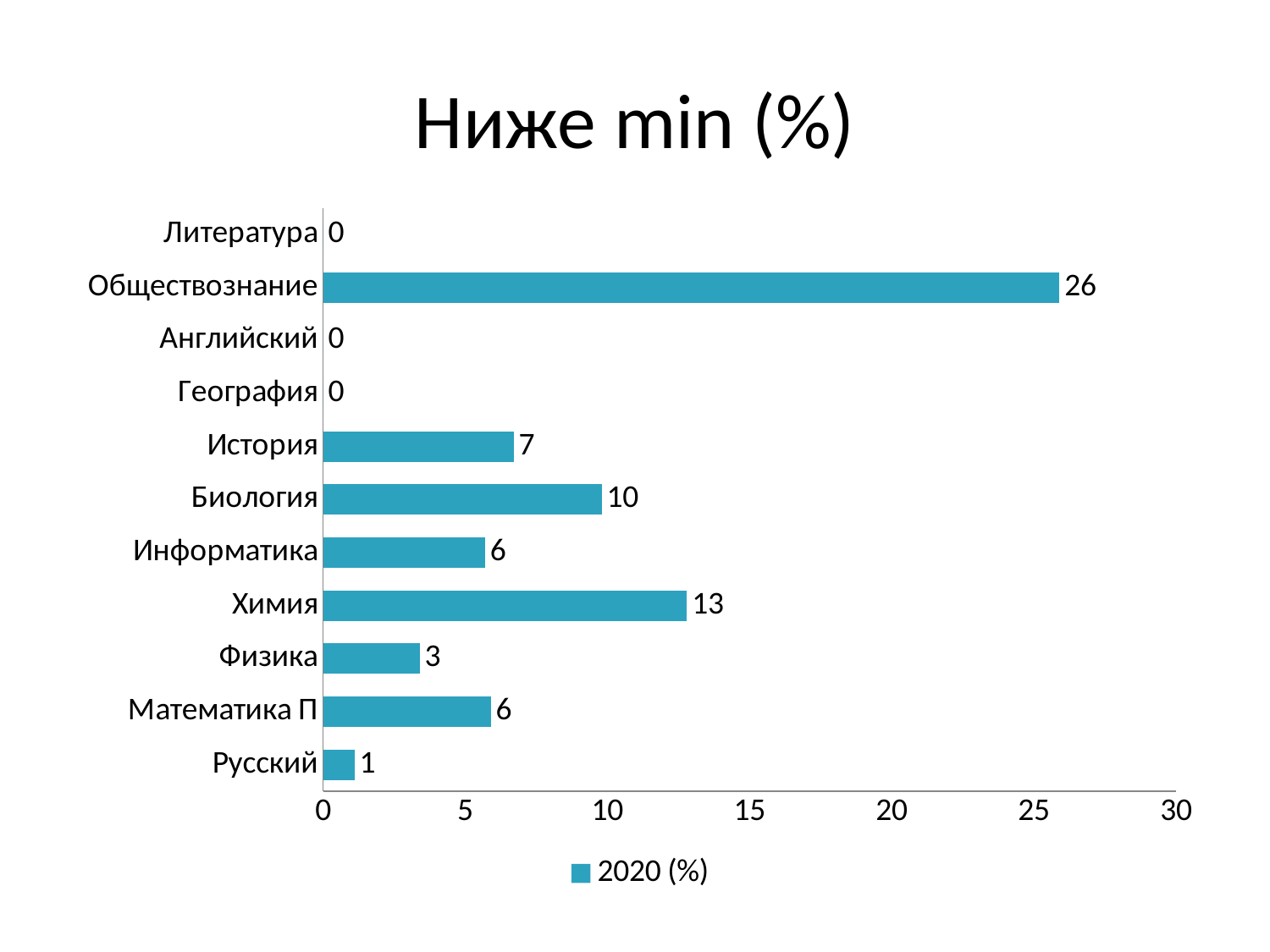
What is the difference between the values for Биология and История? 3 Is the value for Обществознание greater or less than 25? greater How many series does the legend list? 1 What is the difference between the values for Обществознание and Химия? 13 What is the value for Химия? 13 What is the value for Обществознание? 26 Which category has the highest value? Обществознание Which is larger, the value for Биология or the value for История? Биология What is the title of the chart? Ниже min (%) What kind of chart is shown on the slide? bar chart What is the value for Русский? 1 How many categories are shown on the chart? 11